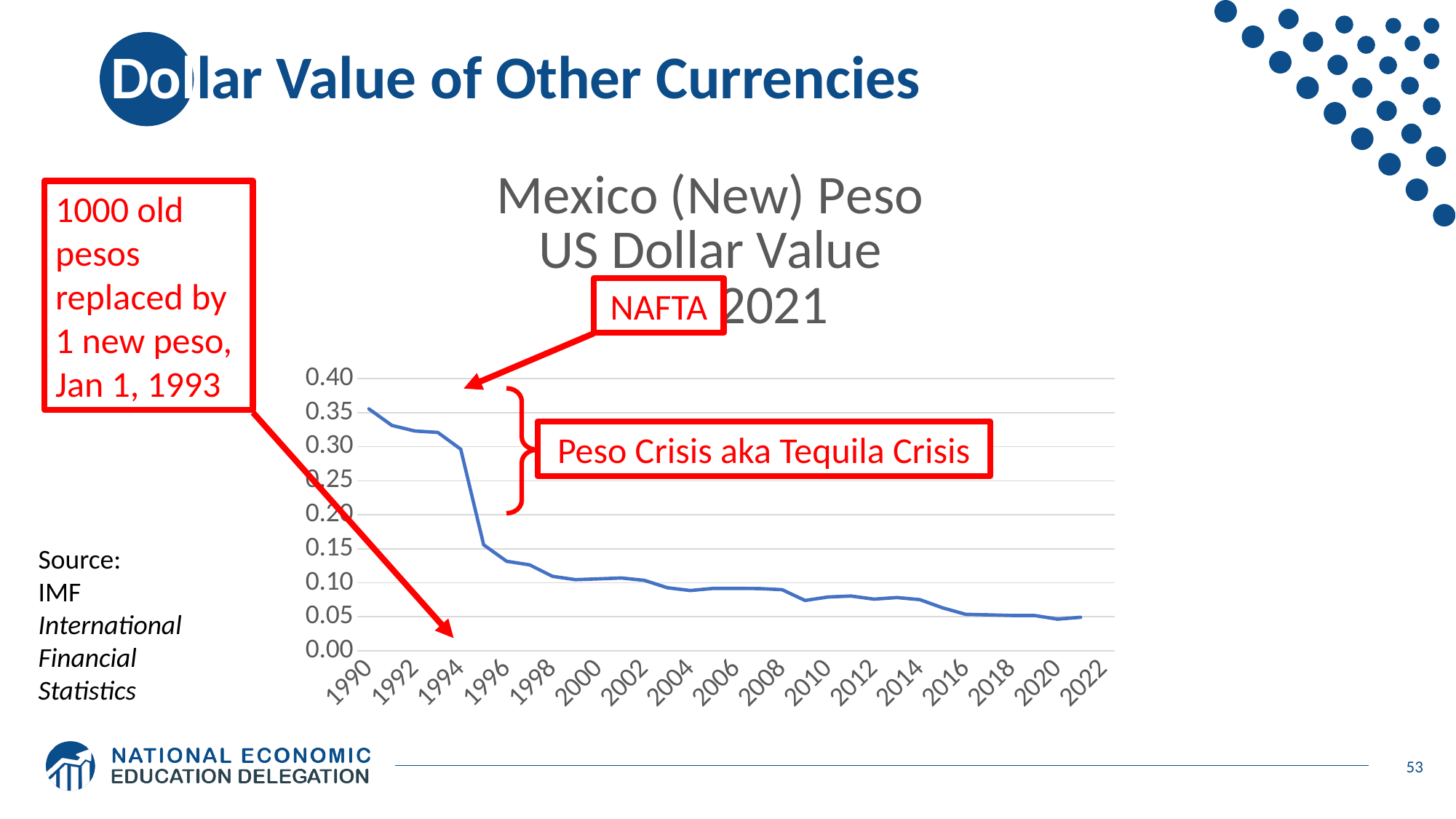
In which year is the US dollar value of the Mexican peso highest? 1990 How many data series are plotted on the chart? 1 What event does the annotation label the sharp drop in the peso's value around 1994-1995? Peso Crisis aka Tequila Crisis Is the value for 2020 greater or less than 0.10? less Is the value for 2000 greater or less than 0.15? less What kind of chart is shown on the slide? line chart Is the value for 1996 greater or less than 0.20? less Which year has the larger value, 1994 or 1996? 1994 Which year has the larger value, 1990 or 2010? 1990 Overall, does the US dollar value of the Mexican peso rise or fall from 1990 to 2021? fall